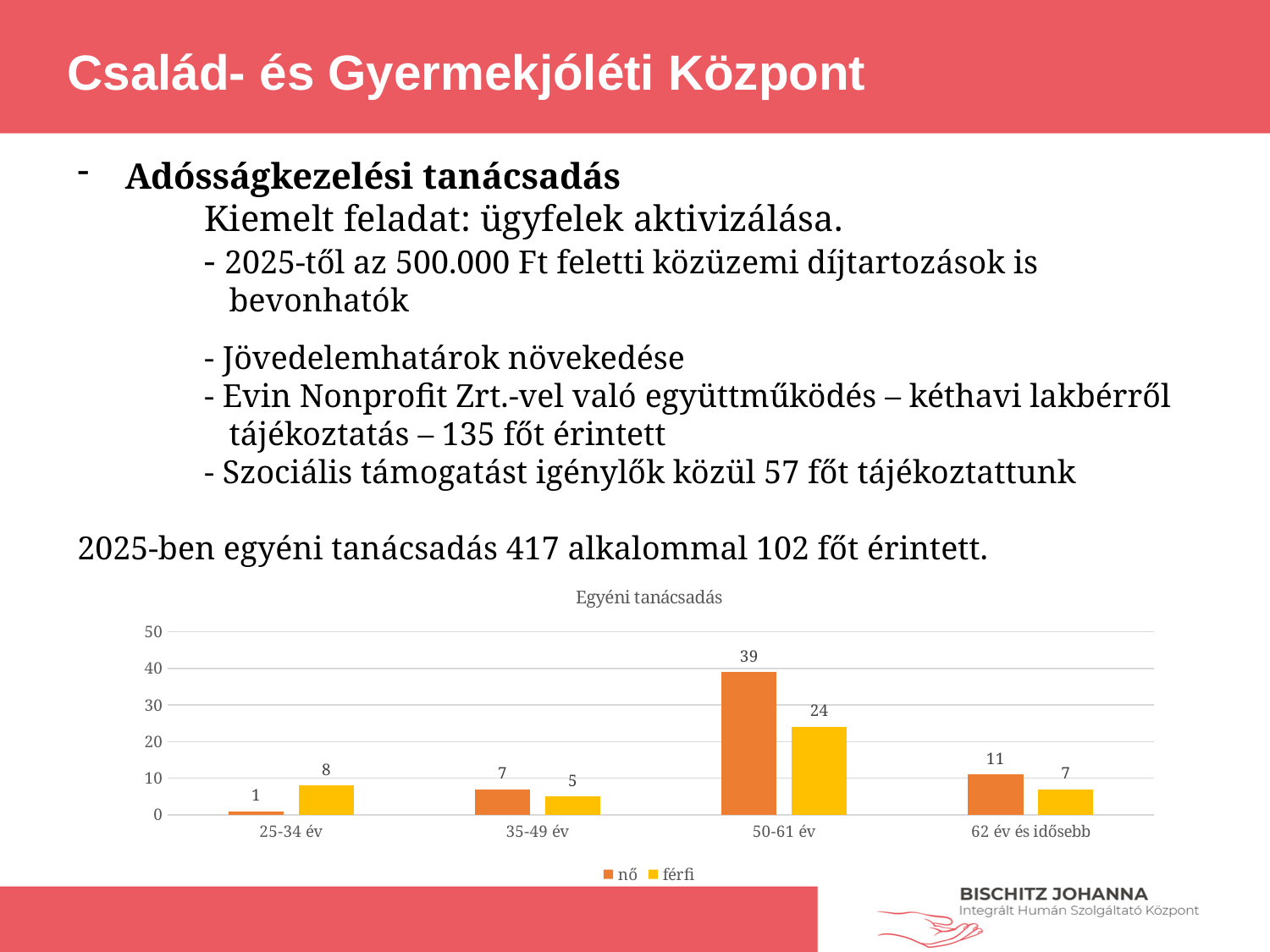
What is the difference between the 'nő' and 'férfi' values in the 50-61 év category? 15 In the 25-34 év category, which is larger, 'nő' or 'férfi'? férfi What kind of chart is shown on the slide? bar chart What is the value for 'férfi' in the 25-34 év category? 8 What is the title of the chart? Egyéni tanácsadás Which age category has the highest value for 'nő'? 50-61 év Which age category has the lowest value for 'férfi'? 35-49 év How many age categories are shown on the x axis? 4 What is the value for 'nő' in the 50-61 év category? 39 What is the value for 'nő' in the 62 év és idősebb category? 11 What is the total of 'nő' and 'férfi' in the 35-49 év category? 12 How many series does the legend list? 2